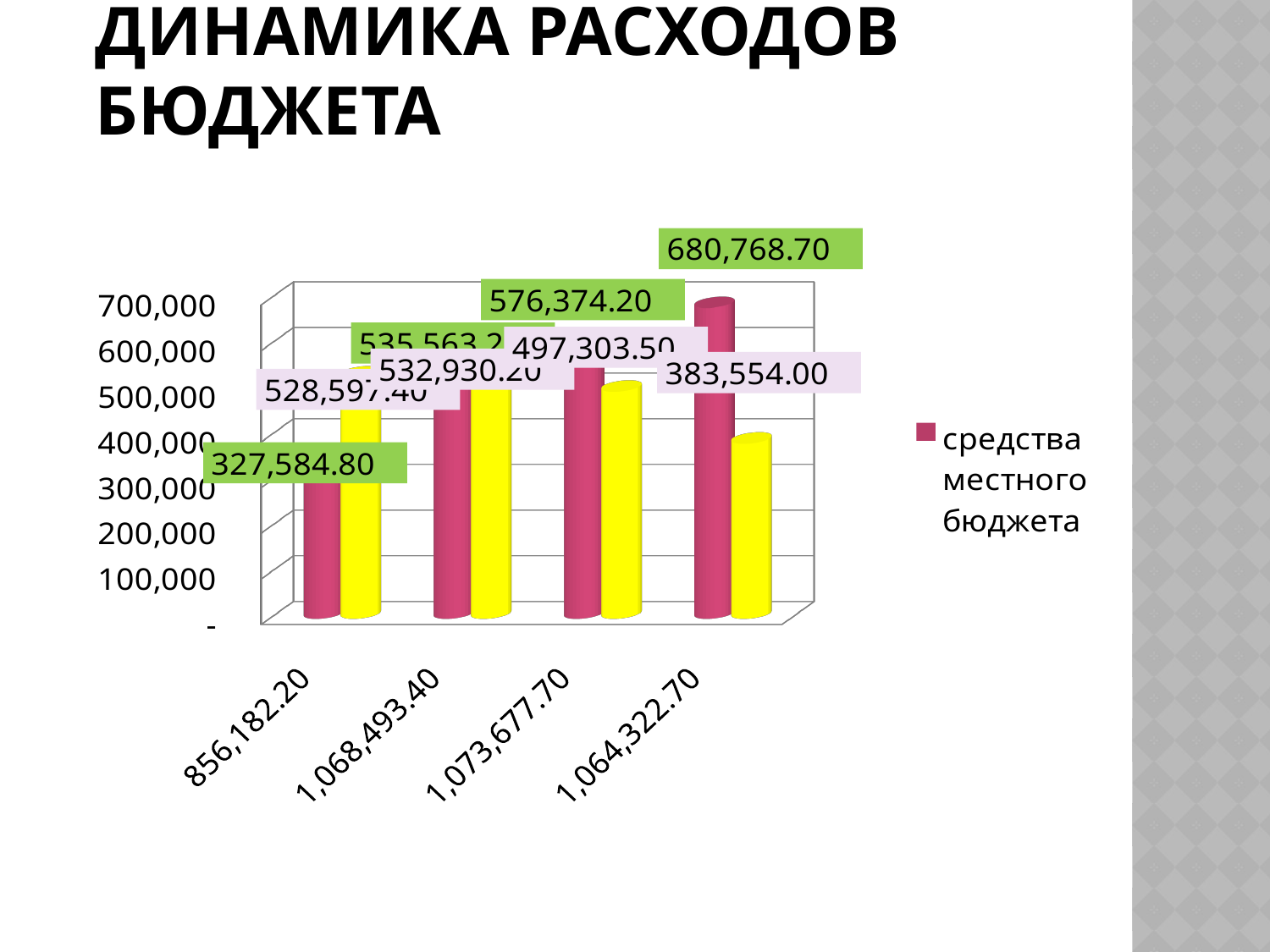
What value is labelled on the yellow bar for the category 1,064,322.70? 383,554.00 What is the value of средства местного бюджета for the category 856,182.20? 327,584.80 What is the difference between средства местного бюджета for 1,064,322.70 and for 856,182.20? 353,183.90 For which category is средства местного бюджета highest? 1,064,322.70 What is the value of средства местного бюджета for the category 1,064,322.70? 680,768.70 Do the values of средства местного бюджета rise or fall from left to right along the x axis? rise What is the value of средства местного бюджета for the category 1,073,677.70? 576,374.20 In the category 856,182.20, which bar is taller, the magenta bar or the yellow bar? the yellow bar What kind of chart is shown on the slide? bar chart How many categories are shown along the x axis of the chart? 4 What series name is shown in the chart legend? средства местного бюджета For which category is средства местного бюджета lowest? 856,182.20